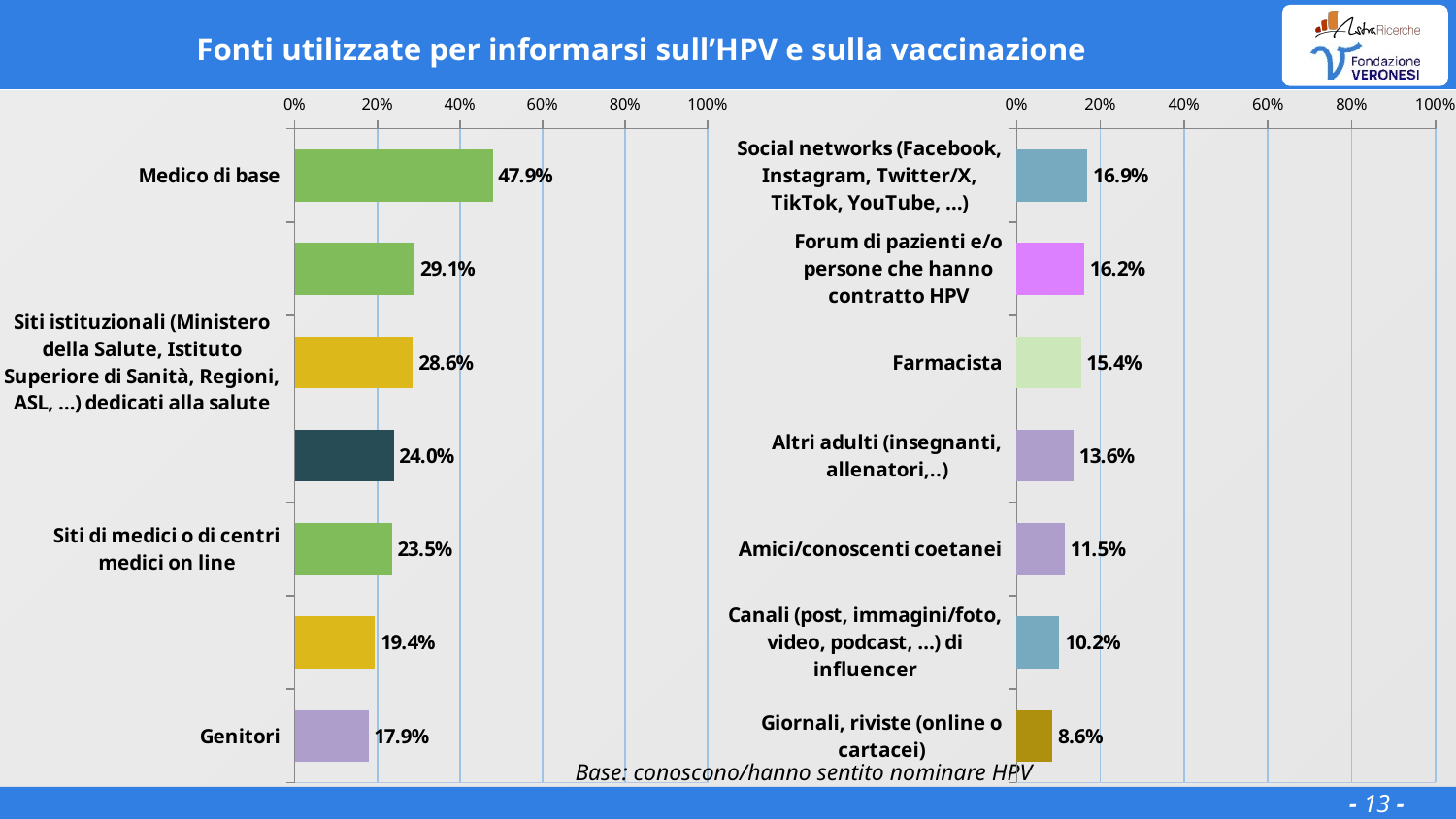
On the right chart, which category has the lowest value? Giornali, riviste (online o cartacei) On the left chart, what is the value for Medico di base? 47.9% On the right chart, which is larger: Farmacista or Altri adulti (insegnanti, allenatori,..)? Farmacista What type of chart is used on the left side of the slide? Bar chart On the left chart, what is the value for Genitori? 17.9% On the right chart, what is the value for Amici/conoscenti coetanei? 11.5% On the left chart, what is the value for Siti di medici o di centri medici on line? 23.5% On the right chart, which category has the highest value? Social networks (Facebook, Instagram, Twitter/X, TikTok, YouTube, ...) How many bars are shown on the right chart? 7 On the left chart, which category has the highest value? Medico di base On the left chart, what is the difference between Medico di base and Genitori? 30.0% On the right chart, what is the value for Farmacista? 15.4%